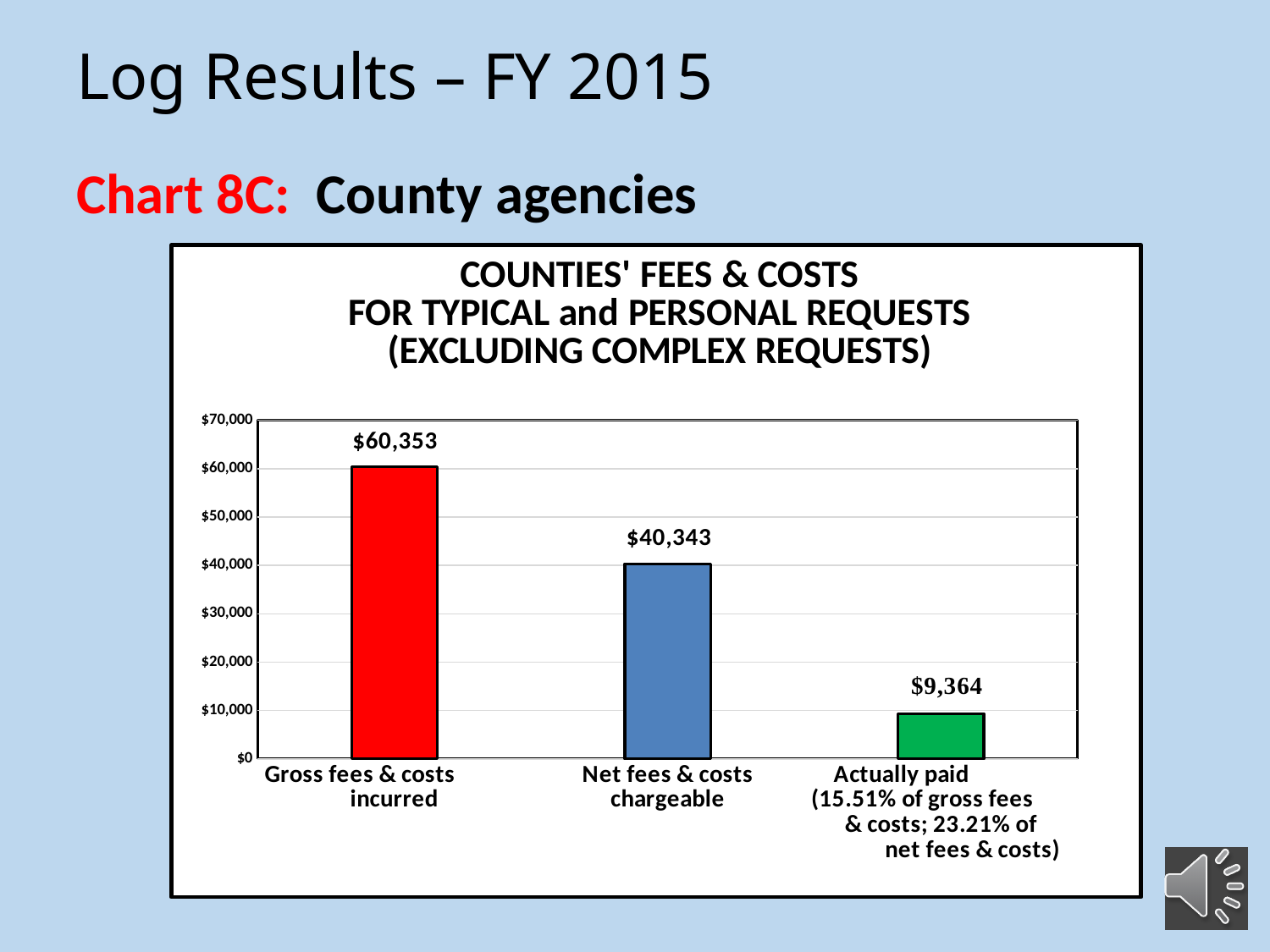
What is the value for Gross fees & costs incurred? $60,353 What kind of chart is shown on the slide? bar chart Which category has the highest value? Gross fees & costs incurred What is the difference between Net fees & costs chargeable and Actually paid? $30,979 Which is larger, Net fees & costs chargeable or Actually paid? Net fees & costs chargeable What is the difference between Gross fees & costs incurred and Net fees & costs chargeable? $20,010 What is the value for Actually paid? $9,364 What colour is the bar for Actually paid? green Is the value for Actually paid greater or less than $10,000? less Which category has the lowest value? Actually paid How many categories are shown in the chart? 3 What is the value for Net fees & costs chargeable? $40,343